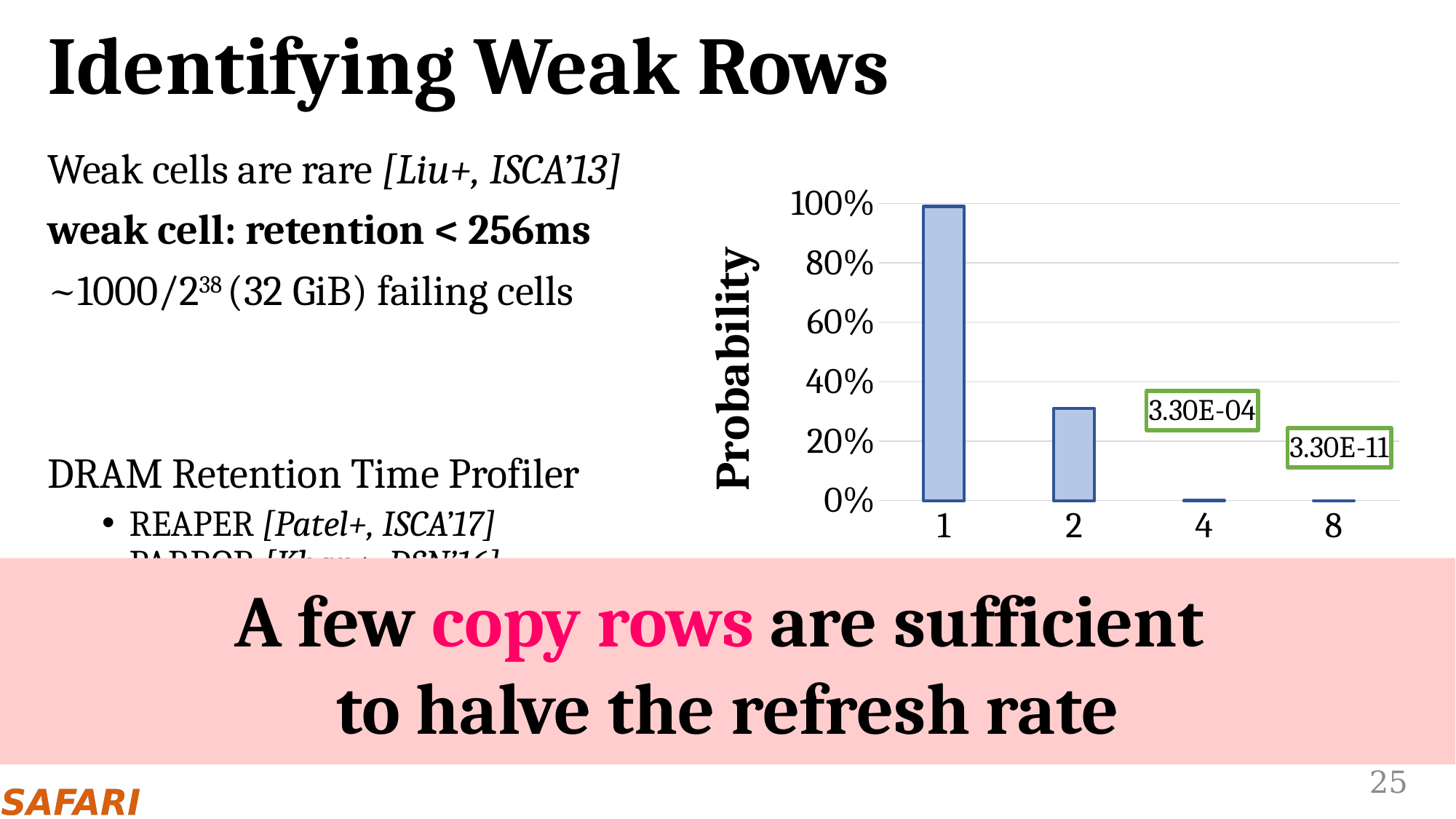
How many categories are shown on the x axis of the chart? 4 Which category has the highest probability in the chart? 1 Is the probability for category 1 greater or less than 80%? greater Do the probabilities rise or fall as you move from category 1 to category 8 along the x axis? fall What is the value printed for category 4 in the chart? 3.30E-04 Is the probability for category 2 greater or less than 20%? greater What kind of chart is shown on the slide? bar chart Which category has the lowest probability in the chart? 8 What is the label on the y axis of the chart? Probability Which has a higher probability, category 1 or category 2? 1 What is the value printed for category 8 in the chart? 3.30E-11 Is the probability for category 2 greater or less than 40%? less